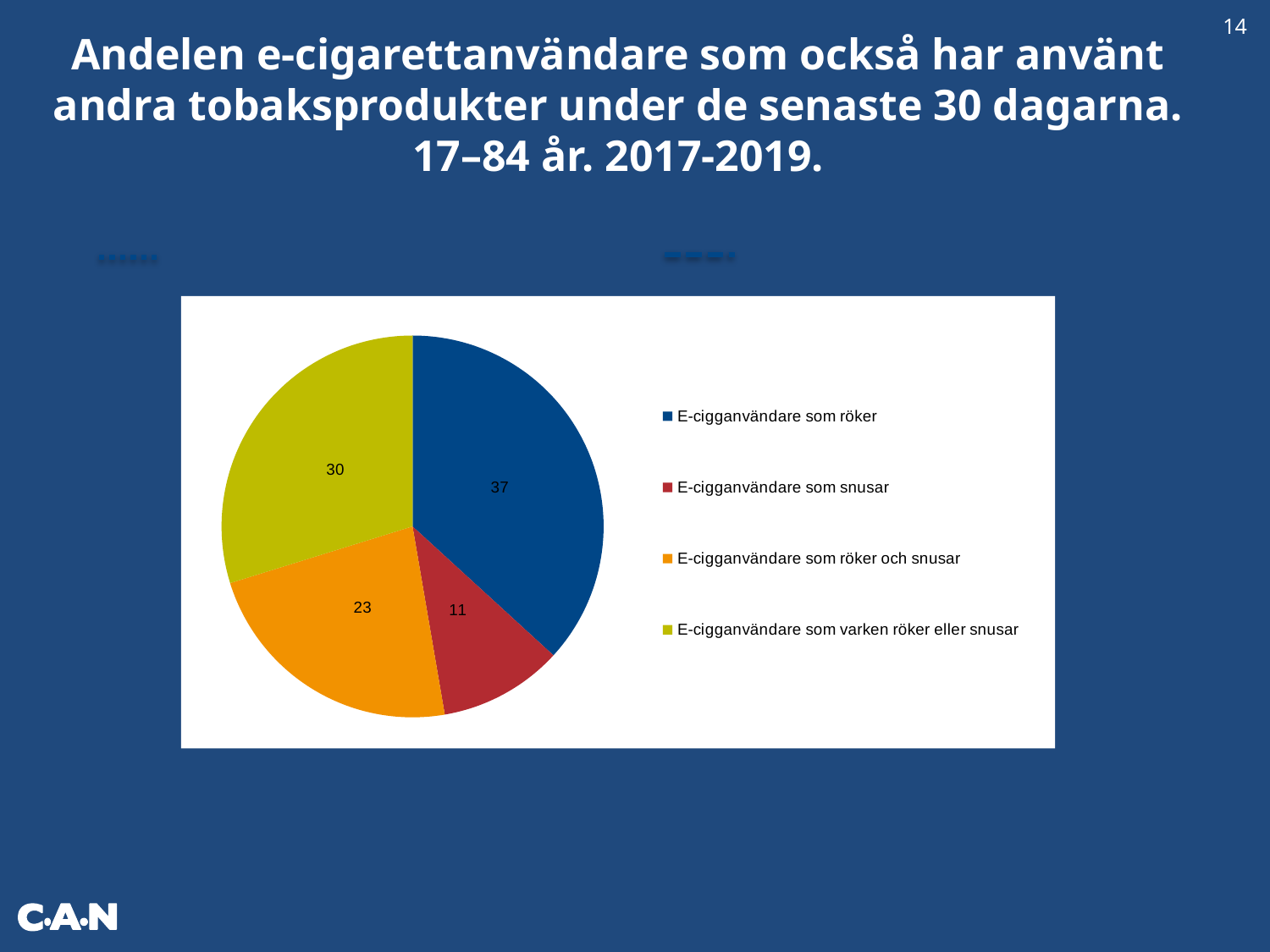
What is the difference between the values for 'E-cigganvändare som varken röker eller snusar' and 'E-cigganvändare som röker och snusar'? 7 What is the difference between the values for 'E-cigganvändare som röker' and 'E-cigganvändare som snusar'? 26 What colour is the slice for 'E-cigganvändare som röker och snusar'? Orange Which category has the smallest slice of the pie? E-cigganvändare som snusar What is the value for 'E-cigganvändare som röker'? 37 What is the value for 'E-cigganvändare som röker och snusar'? 23 What kind of chart is shown on the slide? Pie chart Which category has the largest slice of the pie? E-cigganvändare som röker What is the value for 'E-cigganvändare som varken röker eller snusar'? 30 What is the value for 'E-cigganvändare som snusar'? 11 How many slices does the pie chart have? 4 Which is larger: the value for 'E-cigganvändare som röker och snusar' or the value for 'E-cigganvändare som snusar'? E-cigganvändare som röker och snusar